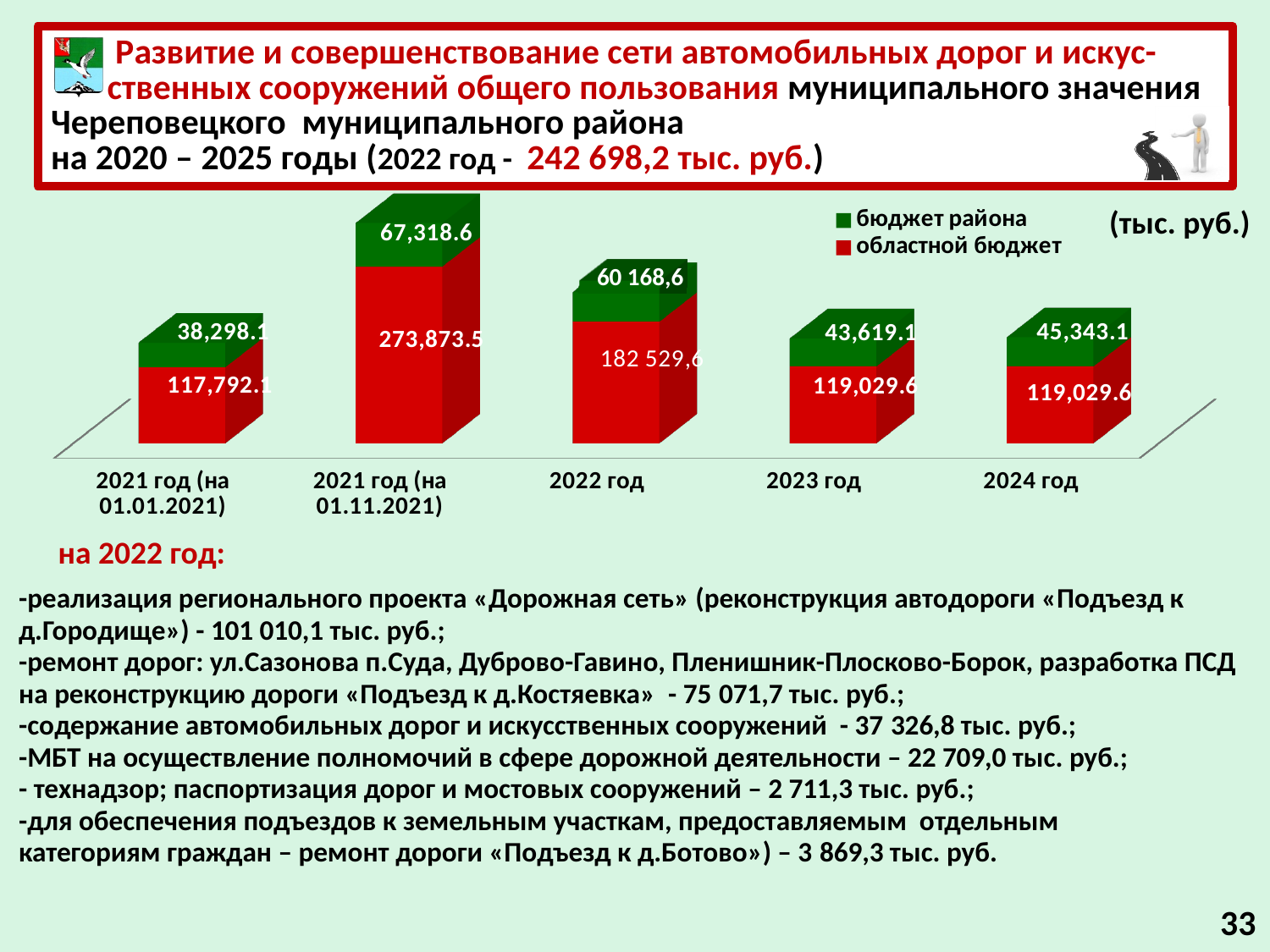
What is the difference between the «бюджет района» values for 2024 год and 2023 год? 1,724.0 What type of chart is shown on the slide? bar chart How many series does the chart legend list? 2 What is the value of «бюджет района» for 2024 год? 45,343.1 What is the value of «бюджет района» for 2022 год? 60 168,6 Which category has the lowest value for «бюджет района»? 2021 год (на 01.01.2021) Which category has the highest value for «областной бюджет»? 2021 год (на 01.11.2021) What is the value of «областной бюджет» for 2022 год? 182 529,6 What is the total of the stacked bar for 2023 год? 162,648.7 How many categories are shown along the x axis of the chart? 5 Which colour represents «бюджет района» in the chart? green What is the value of «областной бюджет» for 2021 год (на 01.11.2021)? 273,873.5